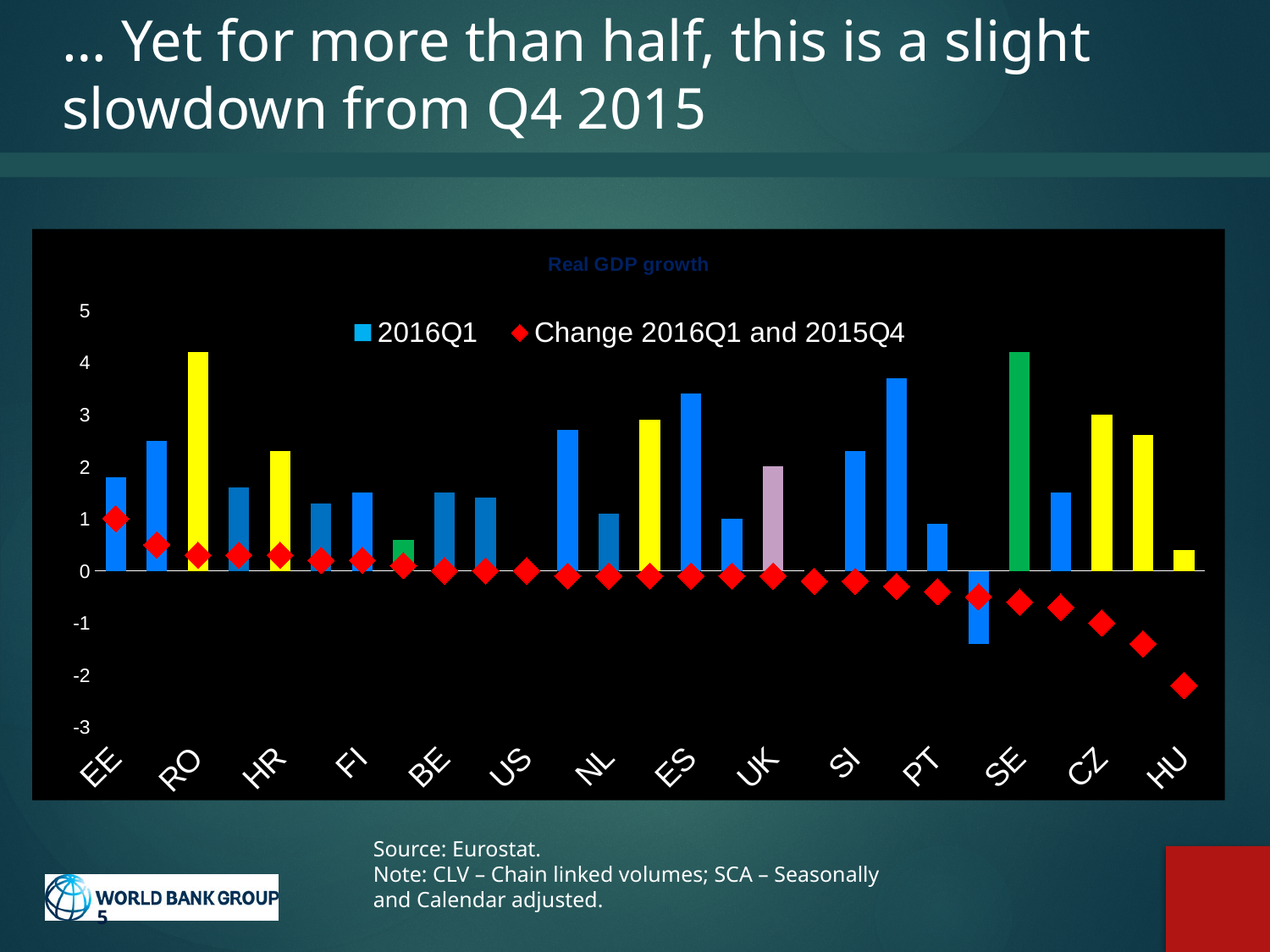
How many country labels are shown on the x axis? 14 What is the title of the chart? Real GDP growth What kind of chart is used to show the 2016Q1 series? bar chart Do the 'Change 2016Q1 and 2015Q4' markers rise or fall from left to right along the x axis? fall Is the 2016Q1 value for SE greater or less than 3? greater Is the 2016Q1 value for ES greater or less than 3? greater Which has the larger 2016Q1 value, ES or PT? ES Is the 2016Q1 value for HU greater or less than 1? less How many series does the legend list? 2 What are the two legend entries? 2016Q1; Change 2016Q1 and 2015Q4